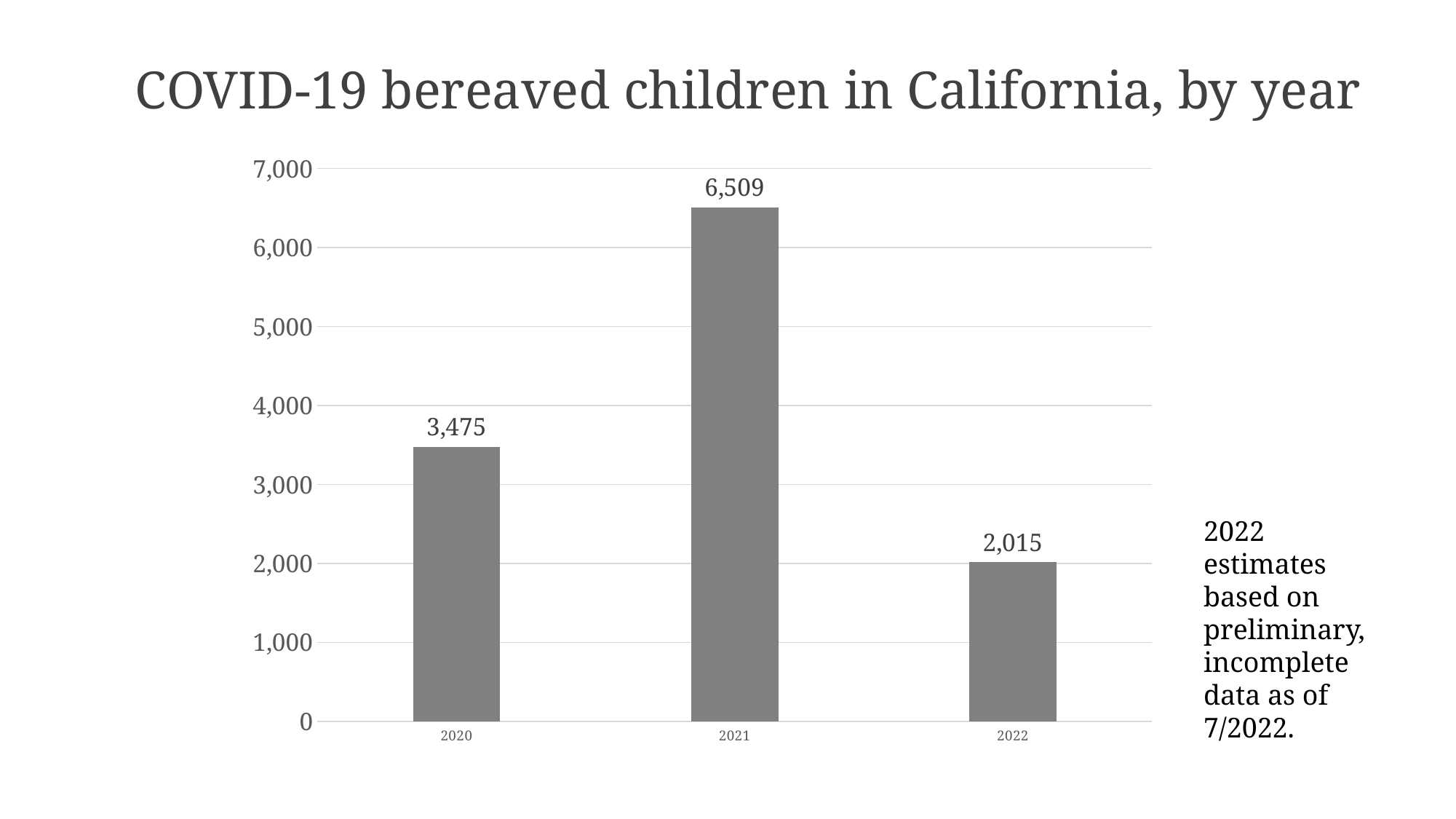
Which year has the lowest value? 2022 Which is larger, the value for 2020 or the value for 2022? 2020 What is the value for 2020? 3,475 What is the difference between the values for 2021 and 2020? 3,034 What is the value for 2021? 6,509 What kind of chart is shown on the slide? bar chart What is the title of the chart? COVID-19 bereaved children in California, by year Is the value for 2021 greater or less than 6,000? greater How many years are shown on the chart? 3 What is the value for 2022? 2,015 What is the difference between the values for 2020 and 2022? 1,460 Which year has the highest value? 2021